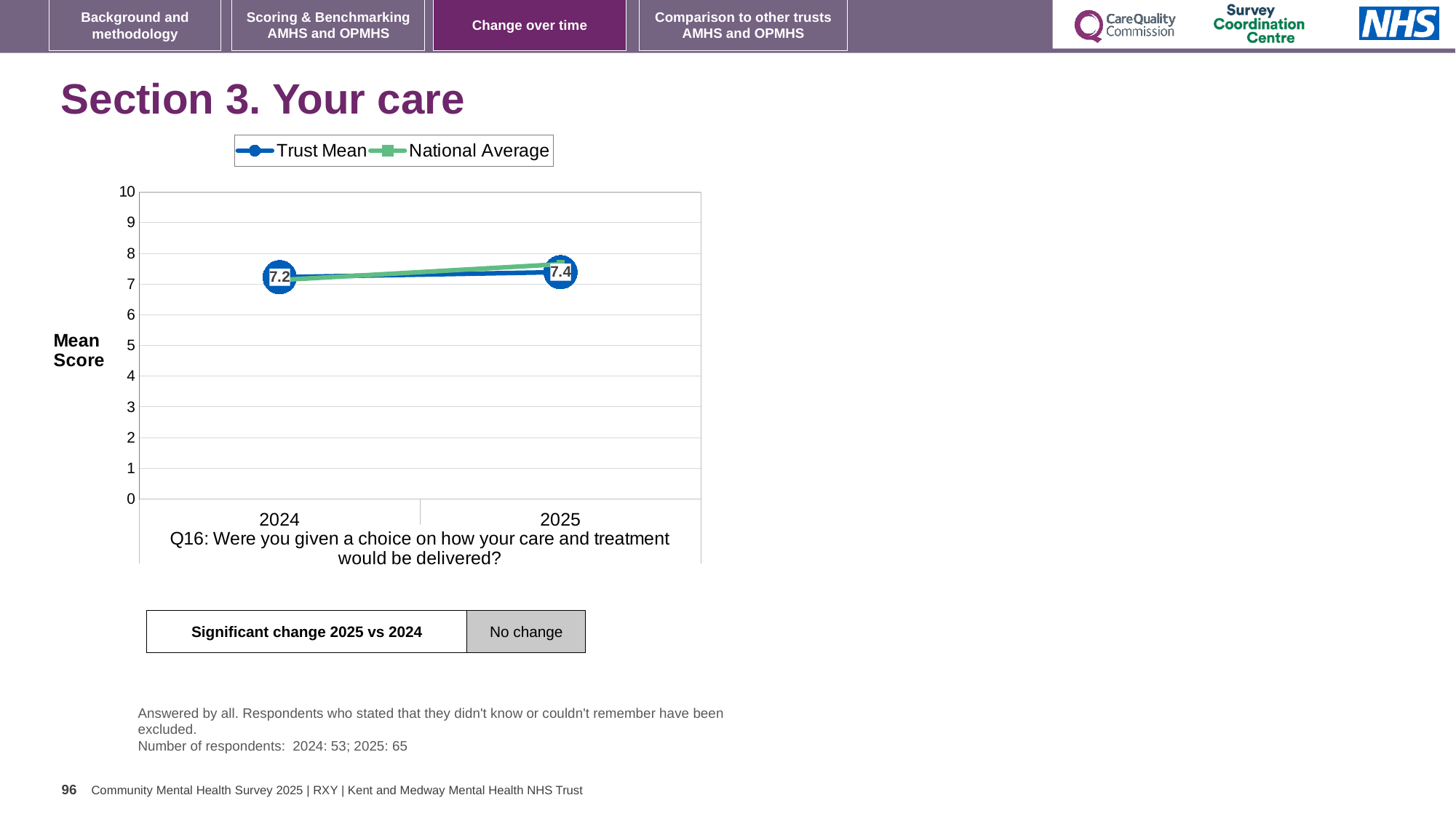
By how much did the Trust Mean change from 2024 to 2025? 0.2 What kind of chart is shown on the slide? line chart Is the National Average value for 2025 greater or less than 5? greater How many series does the legend list? 2 Which year has the higher Trust Mean score, 2024 or 2025? 2025 How many years are plotted on the x axis? 2 What are the two series named in the legend? Trust Mean and National Average What is the Trust Mean score for 2024? 7.2 Is the Trust Mean value for 2024 greater or less than 8? less What is the Trust Mean score for 2025? 7.4 What is the label on the y axis of the chart? Mean Score Does the Trust Mean rise or fall from 2024 to 2025? rise